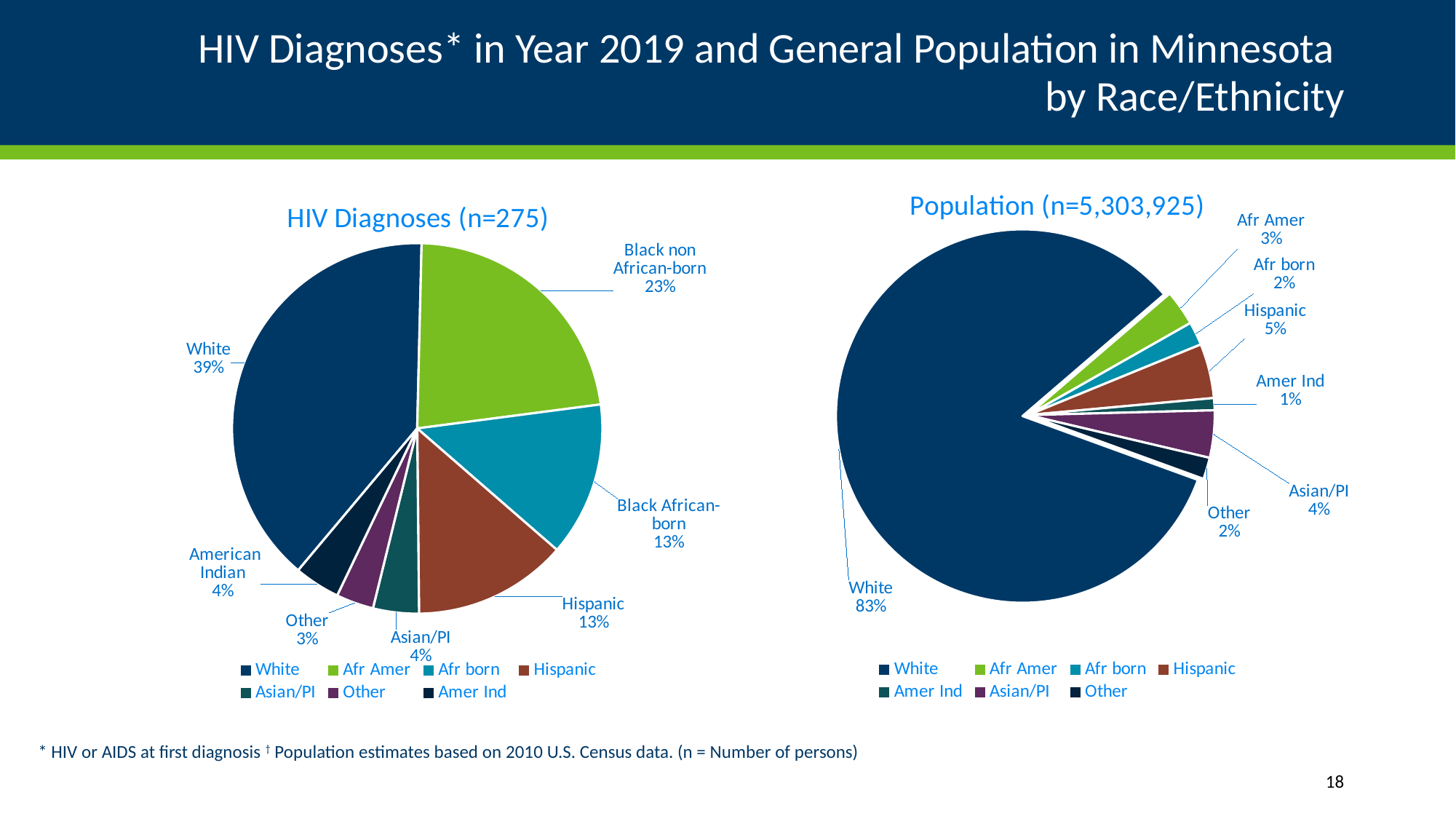
In the HIV Diagnoses (n=275) pie chart, which category has the largest slice? White In the HIV Diagnoses (n=275) pie chart, which category has the smallest slice? Other In the Population (n=5,303,925) pie chart, what share is labelled for Hispanic? 5% What type of chart is used for the Population (n=5,303,925) chart? Pie chart In the HIV Diagnoses (n=275) pie chart, what share is labelled for Hispanic? 13% In the Population (n=5,303,925) pie chart, what share is labelled for White? 83% In the Population (n=5,303,925) pie chart, which category has the smallest slice? Amer Ind In the HIV Diagnoses (n=275) pie chart, what is the difference in percentage points between White and Black non African-born? 16 How many entries does the legend of the HIV Diagnoses (n=275) chart list? 7 In the Population (n=5,303,925) pie chart, which is larger, the Afr Amer slice or the Asian/PI slice? Asian/PI